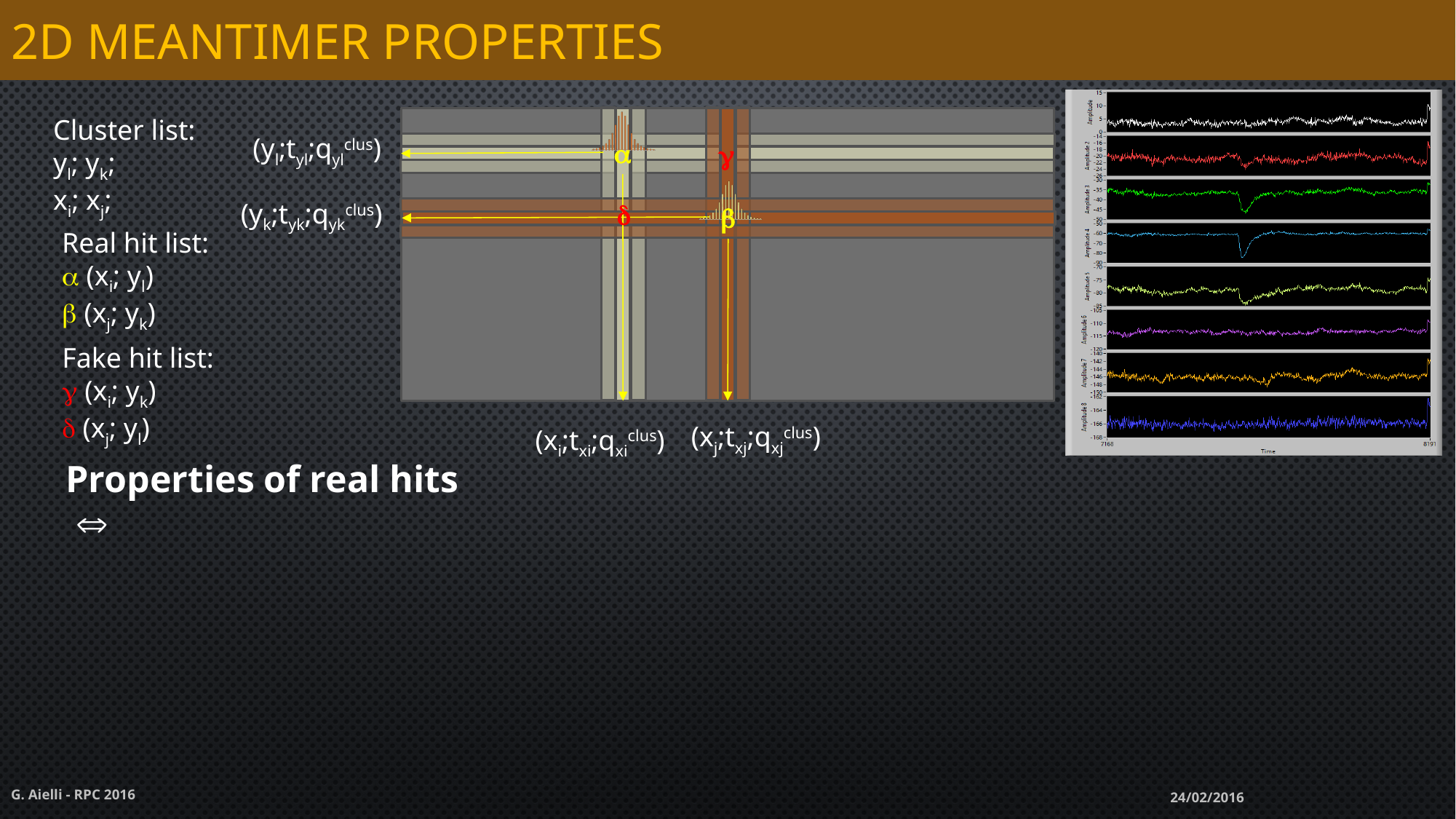
How many separate amplitude panels are stacked in the chart on the right side of the slide? 8 What is the label of the horizontal axis of the chart on the right side of the slide? Time In the chart on the right side of the slide, what colour is the trace in the top panel (Amplitude 1)? white What is the rightmost tick value on the Time axis of the chart on the right side of the slide? 8191 What is the leftmost tick value on the Time axis of the chart on the right side of the slide? 7168 What kind of chart is shown in the panel on the right side of the slide? line chart